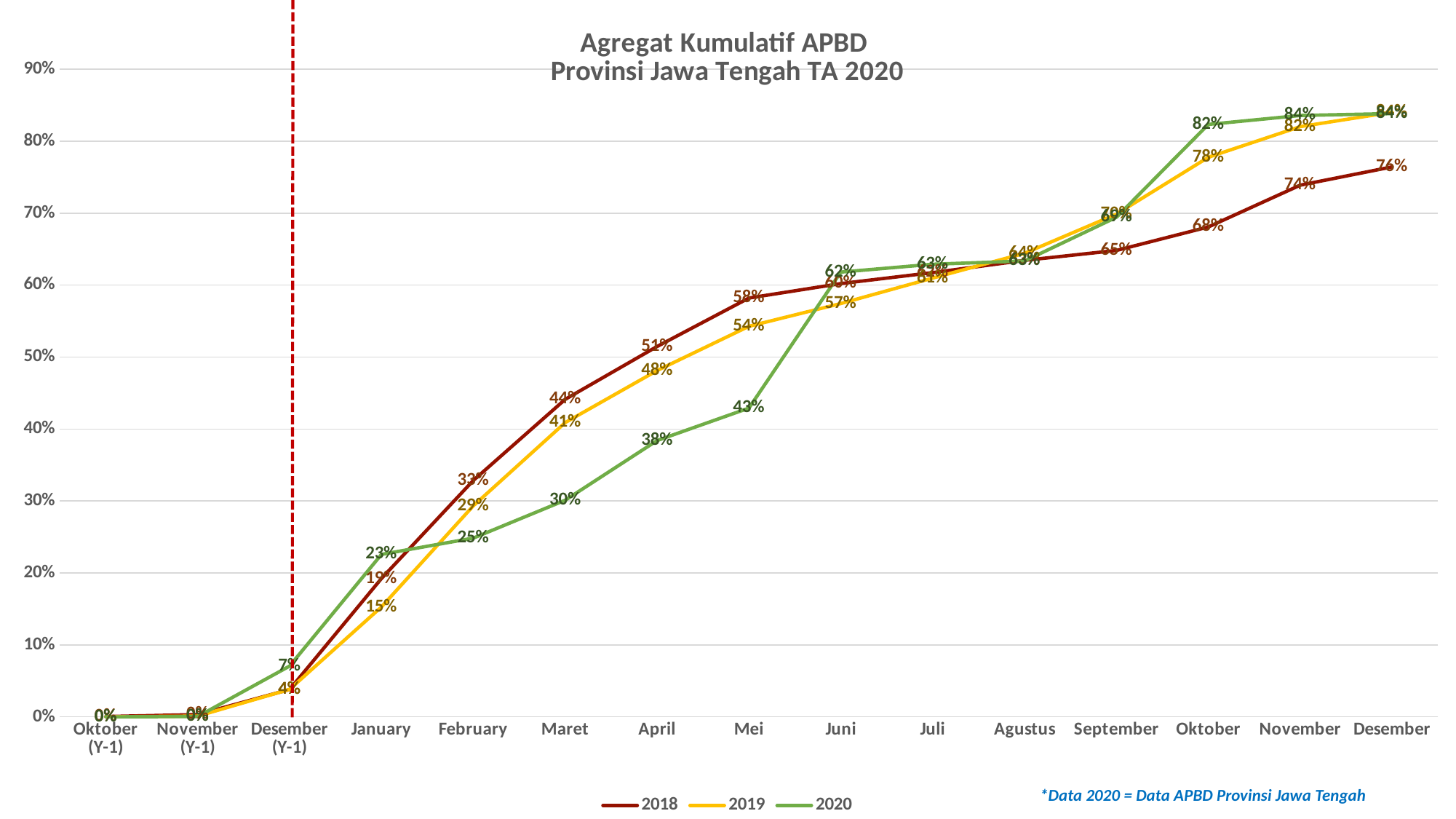
How many categories are shown along the x axis? 15 What is the value for 2019 in Oktober? 78% What is the value for 2018 in Maret? 44% What is the value for 2020 in April? 38% Do the values for the 2019 series rise or fall from January to Desember? Rise What type of chart is shown on the slide? Line chart What is the value for 2018 in Desember (the final point)? 76% What is the difference between the 2018 and 2020 values in Mei? 15 percentage points What is the value for 2020 in Mei? 43% What is the title of the chart? Agregat Kumulatif APBD Provinsi Jawa Tengah TA 2020 Which series has the higher value in Maret, 2018 or 2020? 2018 How many series does the legend list? 3